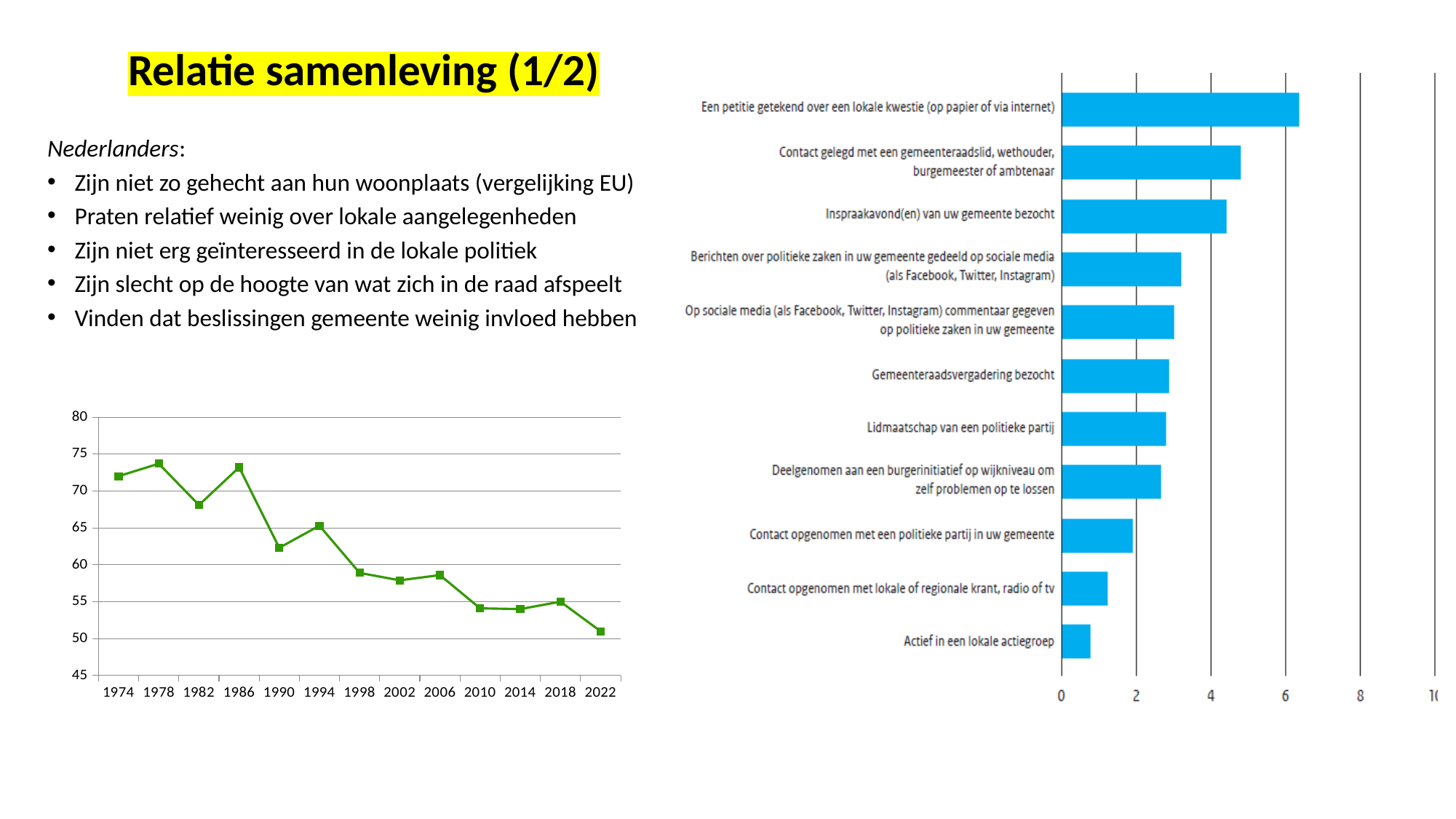
In the line chart at the bottom left, is the value for 1990 greater or less than 65? less In the bar chart on the right, is the value for 'Contact gelegd met een gemeenteraadslid, wethouder, burgemeester of ambtenaar' greater or less than 4? greater What kind of chart is the chart at the bottom left of the slide? line chart In the bar chart on the right, is the value for 'Actief in een lokale actiegroep' greater or less than 2? less In the bar chart on the right, which category has the highest value? Een petitie getekend over een lokale kwestie (op papier of via internet) In the line chart at the bottom left, which year has the lowest value? 2022 In the bar chart on the right, which is larger: 'Inspraakavond(en) van uw gemeente bezocht' or 'Gemeenteraadsvergadering bezocht'? Inspraakavond(en) van uw gemeente bezocht In the bar chart on the right, which category has the lowest value? Actief in een lokale actiegroep What kind of chart is the chart on the right side of the slide? bar chart In the line chart at the bottom left, do the values generally rise or fall from 1974 to 2022? fall In the line chart at the bottom left, how many years are shown on the x axis? 13 How many categories are shown in the bar chart on the right? 11